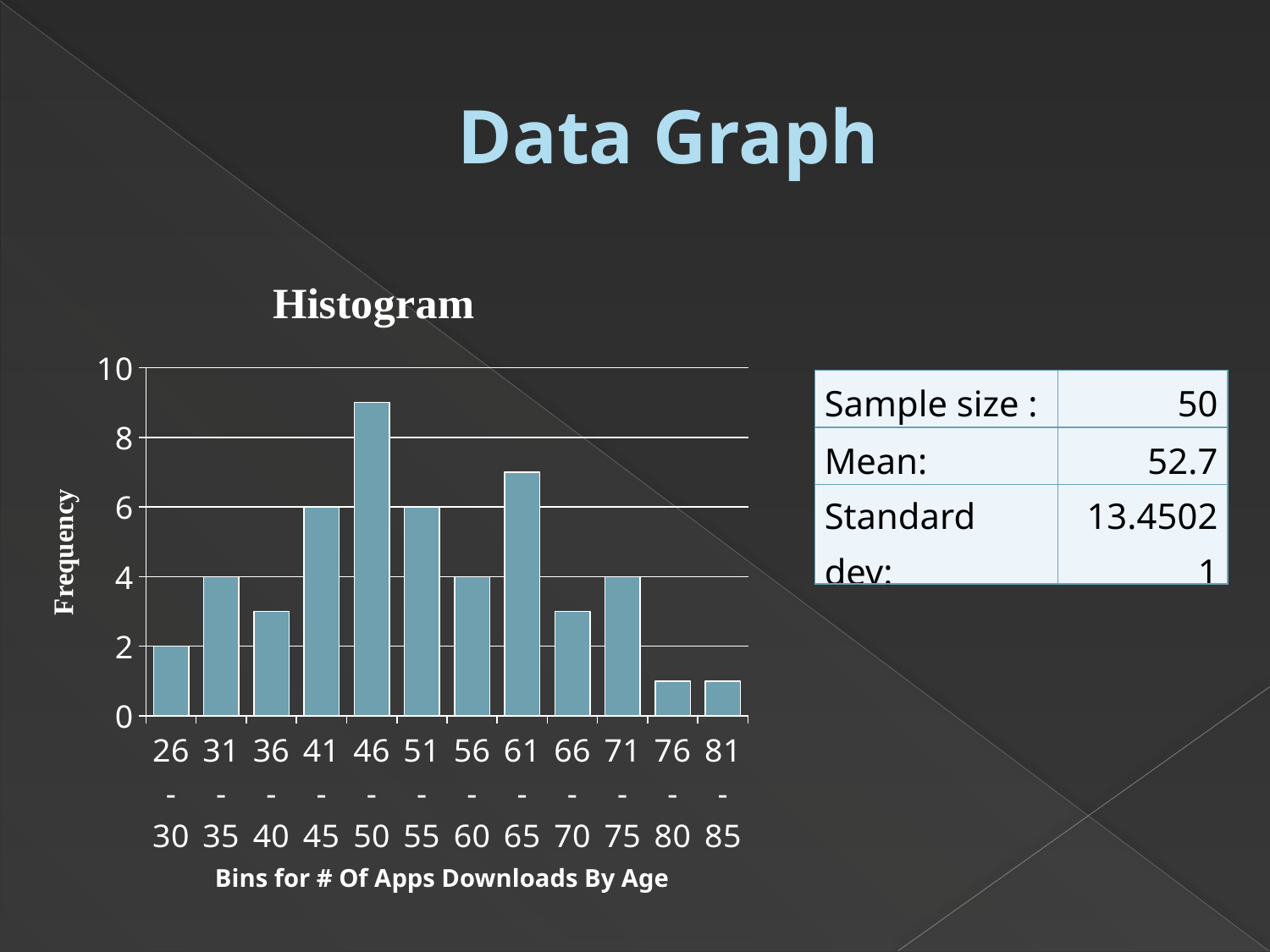
What is the frequency for the 41-45 bin? 6 What is the frequency for the 51-55 bin? 6 What is the frequency for the 31-35 bin? 4 What is the frequency for the 26-30 bin? 2 How many bins are shown on the x axis of the histogram? 12 What is the label of the vertical axis? Frequency Is the frequency for the 76-80 bin greater or less than 2? less Which bin has the highest frequency? 46-50 What type of chart is shown on the slide? bar chart What is the difference in frequency between the 41-45 bin and the 26-30 bin? 4 What is the title of the chart? Histogram Is the frequency for the 46-50 bin greater or less than 8? greater